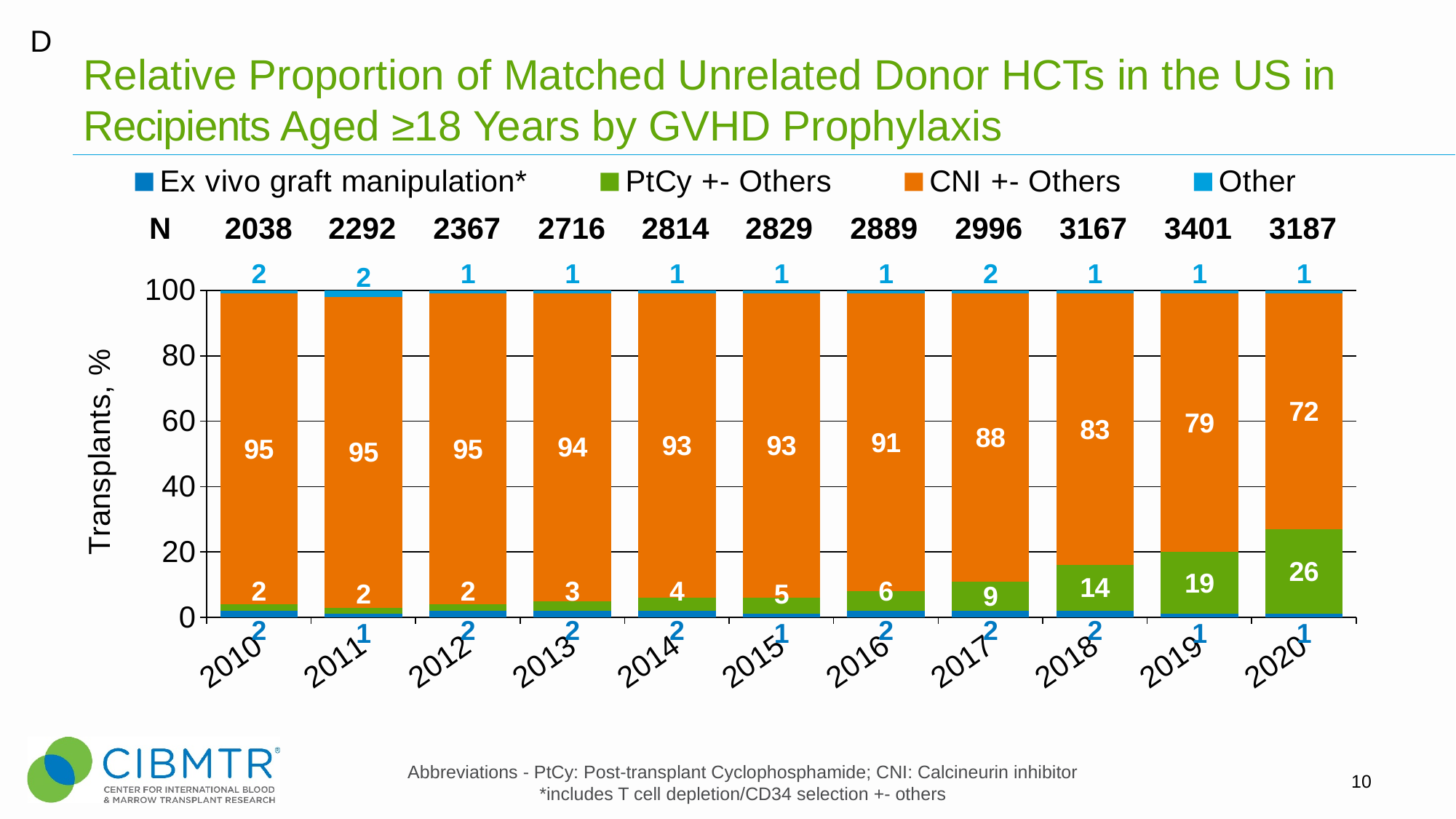
Which year has the lowest CNI +- Others percentage? 2020 What is the CNI +- Others percentage for 2020? 72 Does the PtCy +- Others percentage rise or fall from 2010 to 2020? Rise Which is larger, the PtCy +- Others percentage in 2017 or in 2019? 2019 What kind of chart is shown on the slide? Stacked bar chart How many years are shown on the x axis? 11 Which year has the highest PtCy +- Others percentage? 2020 What is the N value shown for 2019? 3401 What is the difference between the CNI +- Others percentage in 2010 and in 2020? 23 How many series does the legend list? 4 What is the PtCy +- Others percentage for 2018? 14 What is the label of the y axis? Transplants, %